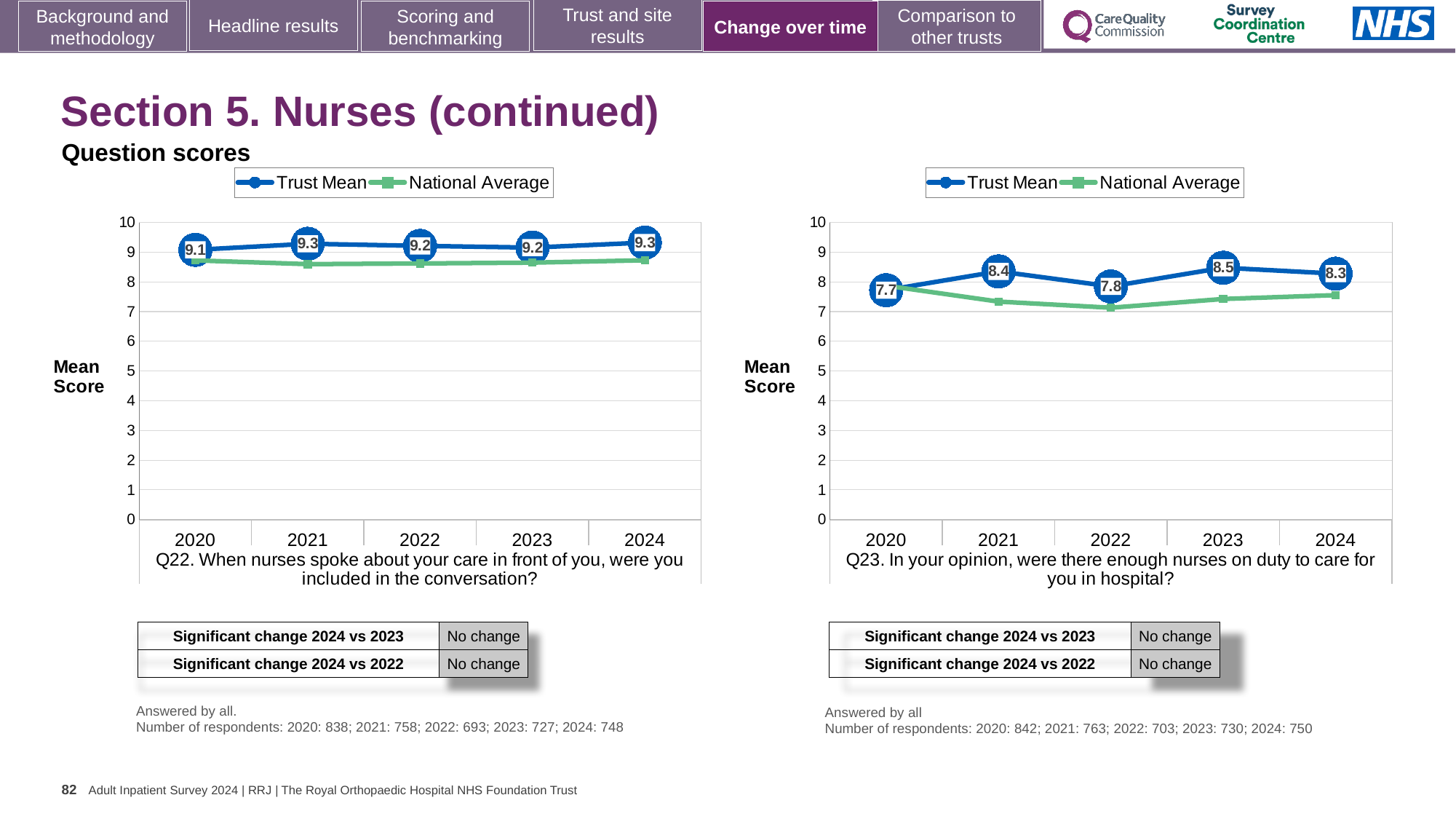
On the Q23 chart (right), which year has the lowest Trust Mean score? 2020 On the Q22 chart (left), what is the Trust Mean score for 2020? 9.1 On the Q23 chart (right), is the National Average value for 2022 greater or less than 8? less How many years are plotted on the x axis of the Q22 chart (left)? 5 On the Q22 chart (left), is the Trust Mean score for 2021 larger or smaller than the Trust Mean score for 2020? larger On the Q22 chart (left), what is the Trust Mean score for 2024? 9.3 On the Q23 chart (right), which year has the highest Trust Mean score? 2023 On the Q23 chart (right), what is the Trust Mean score for 2024? 8.3 What type of chart is used for Q22 (left)? Line chart On the Q23 chart (right), what is the difference between the Trust Mean scores for 2023 and 2020? 0.8 On the Q23 chart (right), what is the Trust Mean score for 2022? 7.8 How many series does the legend of the Q23 chart (right) list? 2